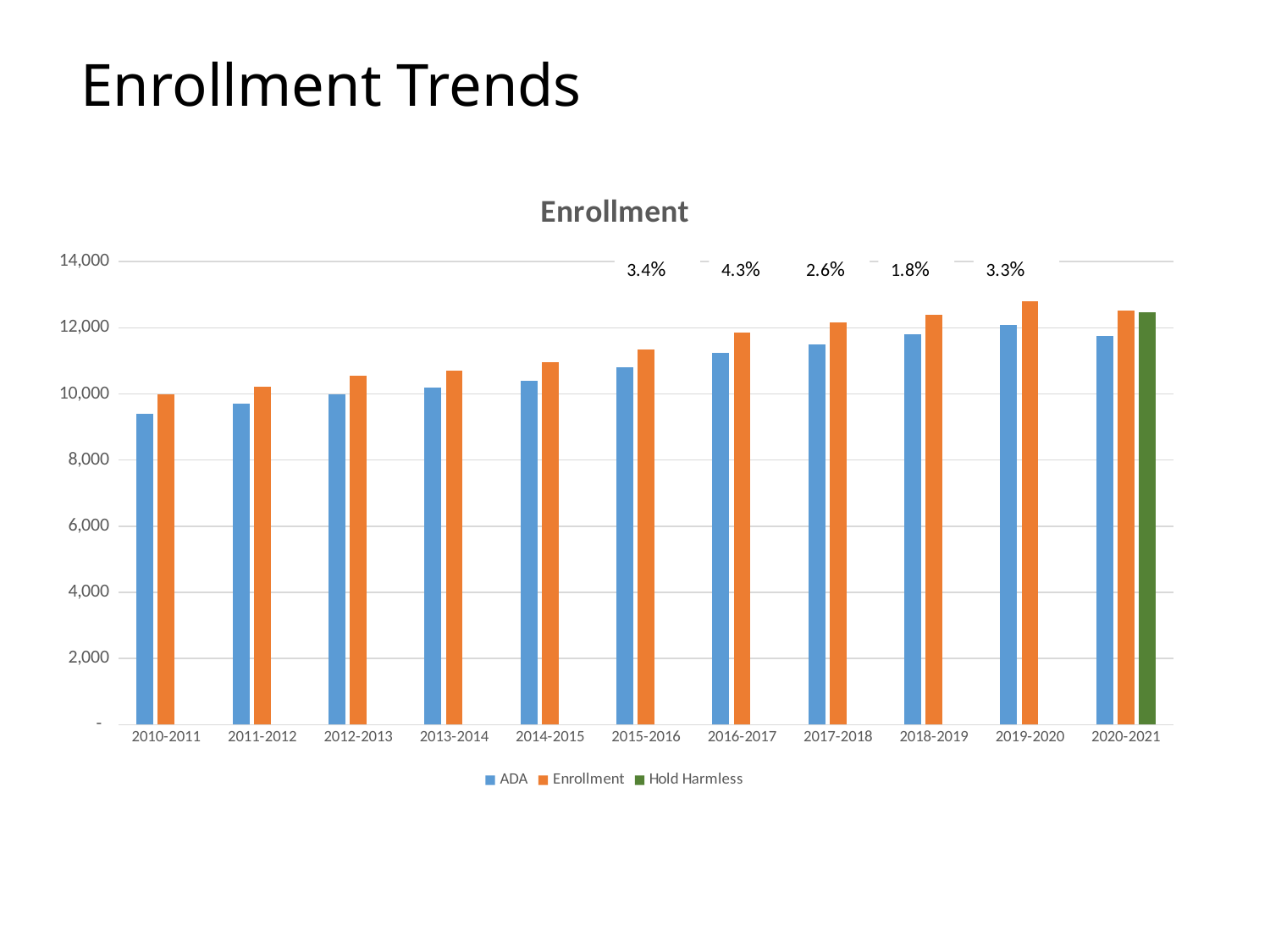
Which school year has the highest Enrollment value? 2019-2020 For which school year is a Hold Harmless bar shown? 2020-2021 Is the Hold Harmless value for 2020-2021 greater or less than 12,000? greater Is the ADA value for 2010-2011 greater or less than 10,000? less What kind of chart is shown on the slide? bar chart How many school years are shown on the x axis? 11 Does the Enrollment series rise or fall from 2010-2011 to 2019-2020? rise Is the ADA value for 2020-2021 greater or less than 12,000? less Which school year has the lowest ADA value? 2010-2011 In 2015-2016, which is larger, ADA or Enrollment? Enrollment How many series does the legend list? 3